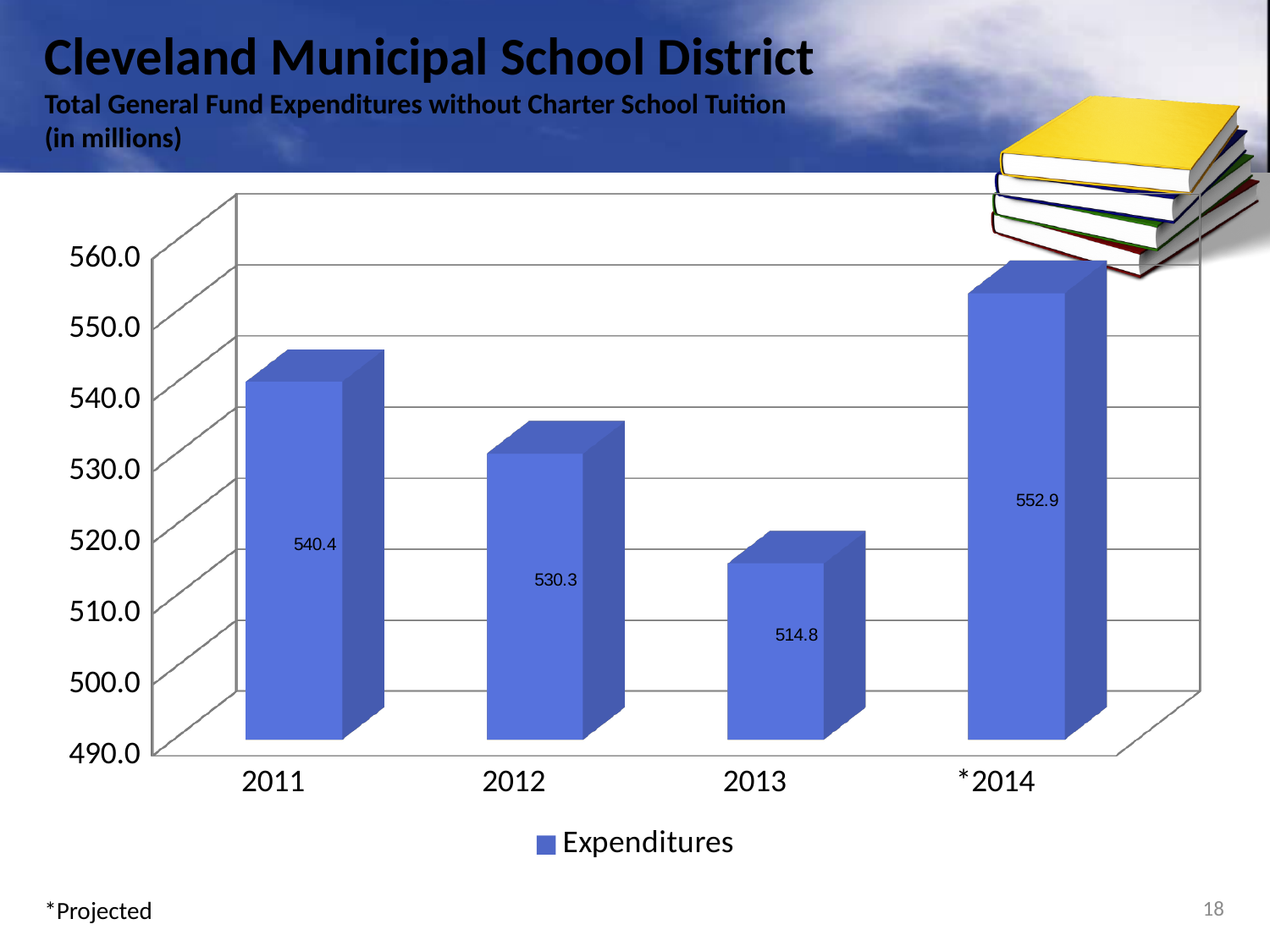
Do the expenditures rise or fall from 2011 to 2013? fall Which is larger, the expenditure for 2012 or for 2013? 2012 What is the difference between the expenditures for 2011 and 2012? 10.1 What is the difference between the expenditures for *2014 and 2013? 38.1 Which year has the highest expenditures? *2014 What is the expenditure value for *2014? 552.9 What is the expenditure value for 2013? 514.8 What kind of chart is shown on the slide? bar chart How many years are shown on the chart? 4 Which year has the lowest expenditures? 2013 How many series does the legend list? 1 What is the expenditure value for 2011? 540.4